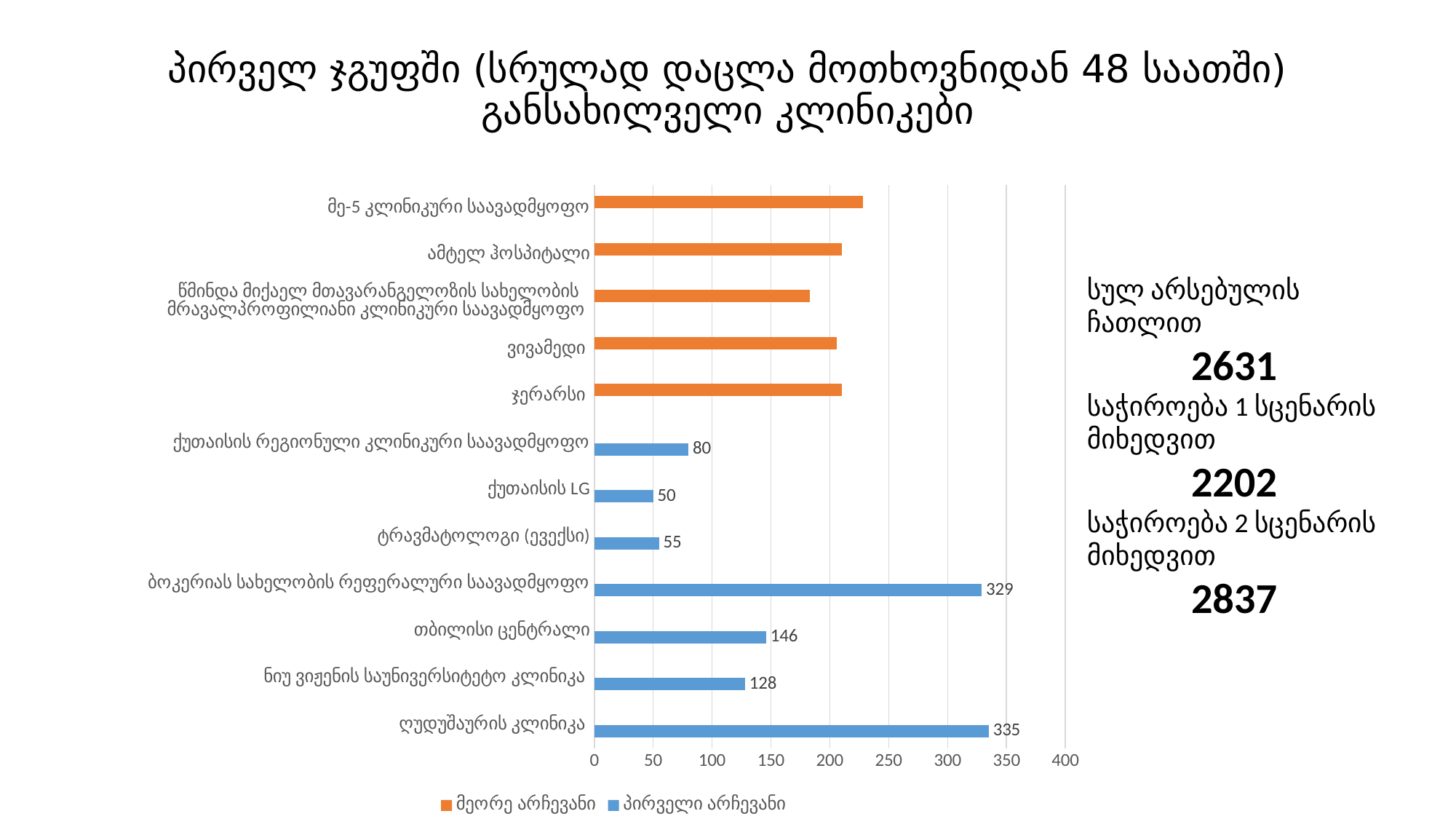
What is the difference between the values for ლუდუშაურის კლინიკა and ბოკერიას სახელობის რეფერალური საავადმყოფო? 6 Which category has the lowest value in the chart? ქუთაისის LG What kind of chart is shown on the slide? Bar chart Which category has the highest value in the chart? ლუდუშაურის კლინიკა Which is larger: the value for თბილისი ცენტრალი or the value for ნიუ ვიჟენის საუნივერსიტეტო კლინიკა? თბილისი ცენტრალი Is the value for მე-5 კლინიკური საავადმყოფო greater or less than 200? greater What value is shown for ბოკერიას სახელობის რეფერალური საავადმყოფო? 329 How many series does the legend list? 2 What value is shown for თბილისი ცენტრალი? 146 How many categories are shown in the chart? 12 What value is shown for ლუდუშაურის კლინიკა? 335 What value is shown for ქუთაისის LG? 50